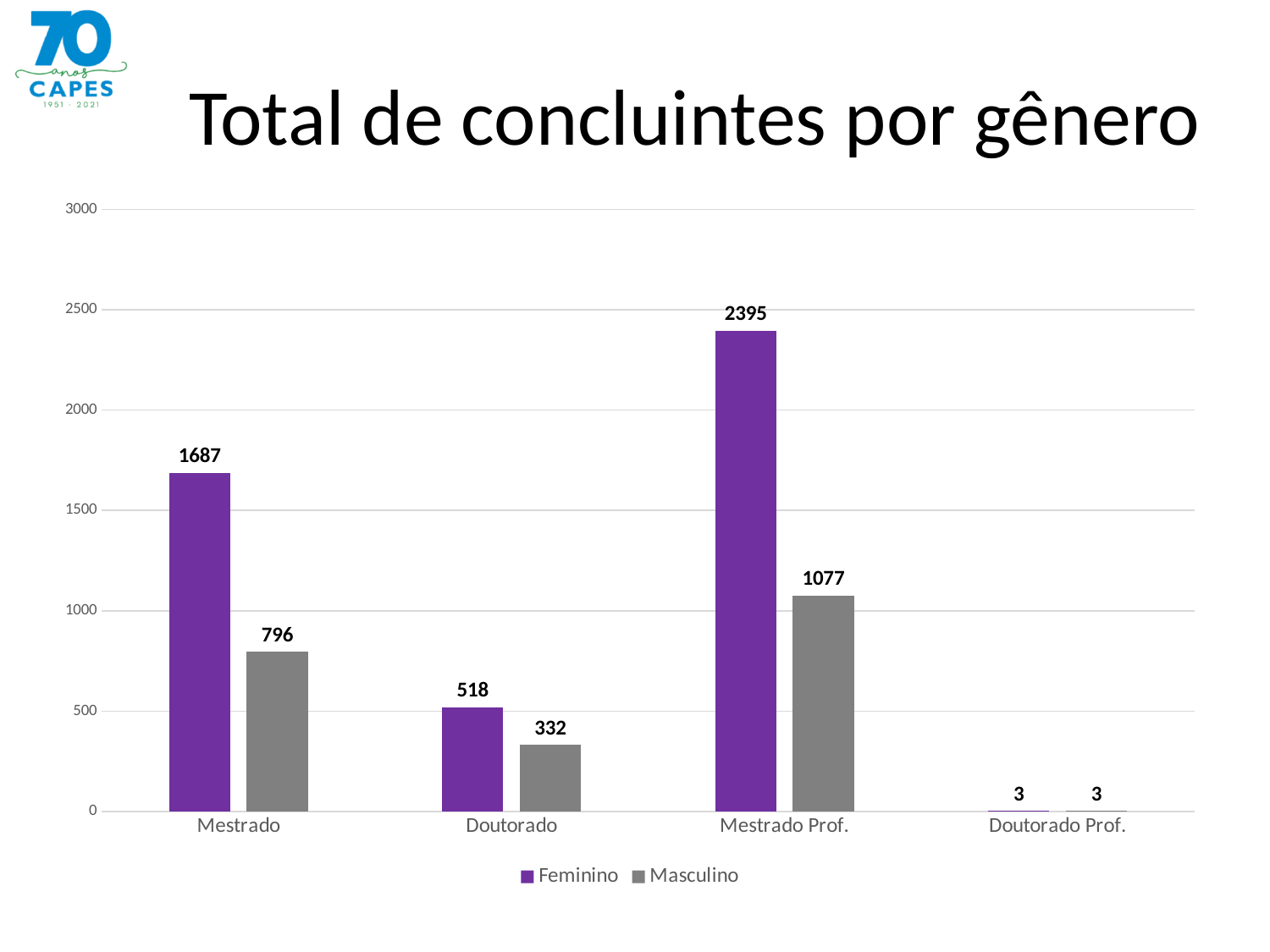
What is the Masculino value for Mestrado Prof.? 1077 What is the difference between the Feminino values for Mestrado and Doutorado? 1169 Which is larger: the Masculino value for Mestrado or the Feminino value for Doutorado? Masculino value for Mestrado Which category has the lowest Masculino value? Doutorado Prof. What kind of chart is shown on the slide? Bar chart Which category has the highest Feminino value? Mestrado Prof. What is the difference between the Feminino and Masculino values for Mestrado Prof.? 1318 What is the Feminino value for Mestrado? 1687 What is the Masculino value for Doutorado? 332 How many categories are shown on the x axis? 4 What is the title of the chart? Total de concluintes por gênero How many series does the legend list? 2